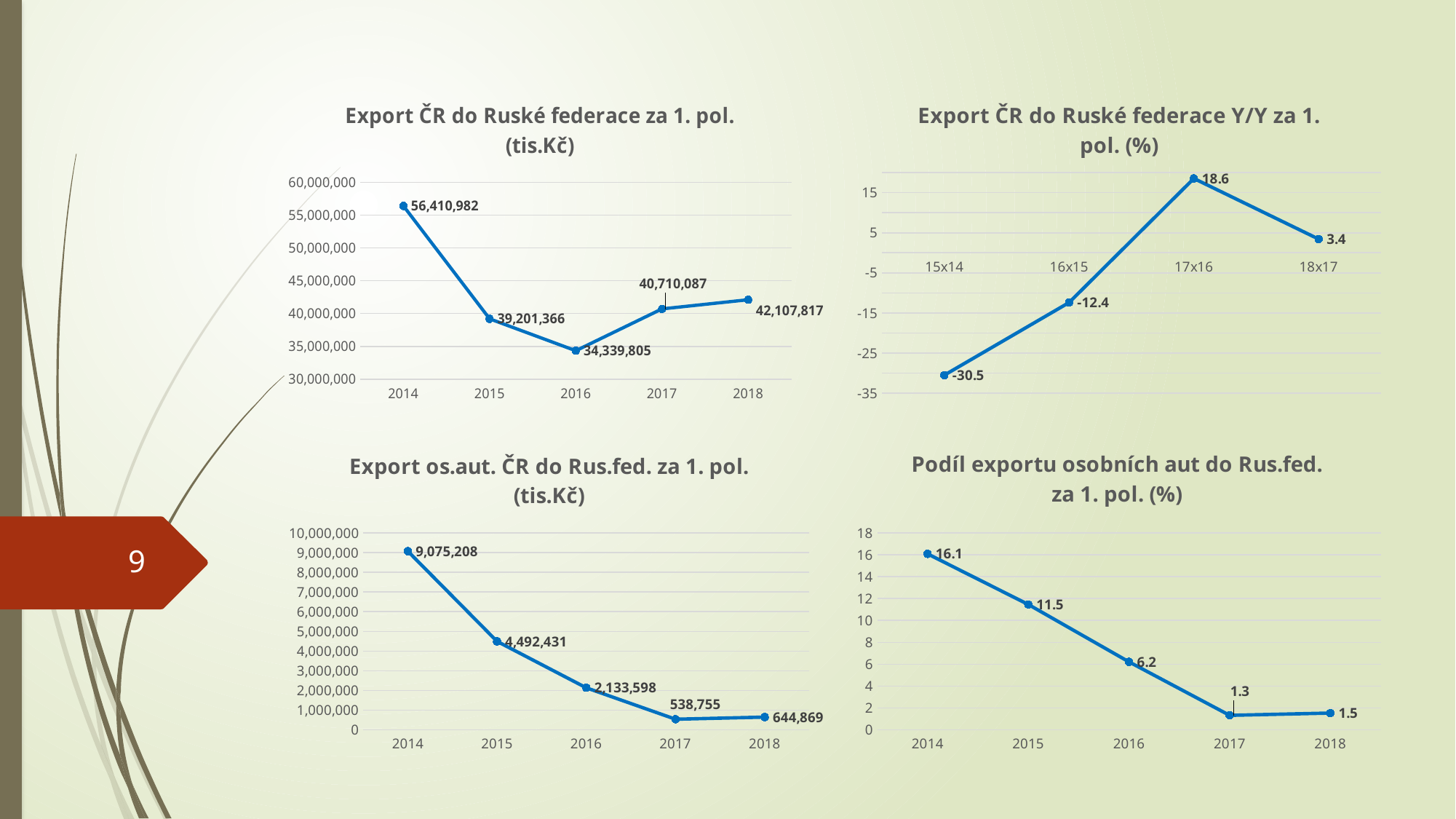
In the bottom-left chart 'Export os.aut. ČR do Rus.fed. za 1. pol. (tis.Kč)', what kind of chart is shown? line chart In the bottom-left chart 'Export os.aut. ČR do Rus.fed. za 1. pol. (tis.Kč)', which is larger, the value for 2017 or the value for 2018? 2018 In the top-left chart 'Export ČR do Ruské federace za 1. pol. (tis.Kč)', what is the difference between the 2014 and 2015 values? 17,209,616 In the bottom-right chart 'Podíl exportu osobních aut do Rus.fed. za 1. pol. (%)', what is the difference between the 2014 and 2015 values? 4.6 In the top-left chart 'Export ČR do Ruské federace za 1. pol. (tis.Kč)', what is the value for 2014? 56,410,982 In the top-left chart 'Export ČR do Ruské federace za 1. pol. (tis.Kč)', which year has the lowest value? 2016 In the top-right chart 'Export ČR do Ruské federace Y/Y za 1. pol. (%)', which category has the lowest value? 15x14 In the bottom-right chart 'Podíl exportu osobních aut do Rus.fed. za 1. pol. (%)', what is the value for 2016? 6.2 In the top-right chart 'Export ČR do Ruské federace Y/Y za 1. pol. (%)', what is the value for 17x16? 18.6 In the bottom-right chart 'Podíl exportu osobních aut do Rus.fed. za 1. pol. (%)', do the values generally rise or fall from 2014 to 2017? fall In the top-right chart 'Export ČR do Ruské federace Y/Y za 1. pol. (%)', how many data points are plotted? 4 In the bottom-left chart 'Export os.aut. ČR do Rus.fed. za 1. pol. (tis.Kč)', what is the value for 2017? 538,755